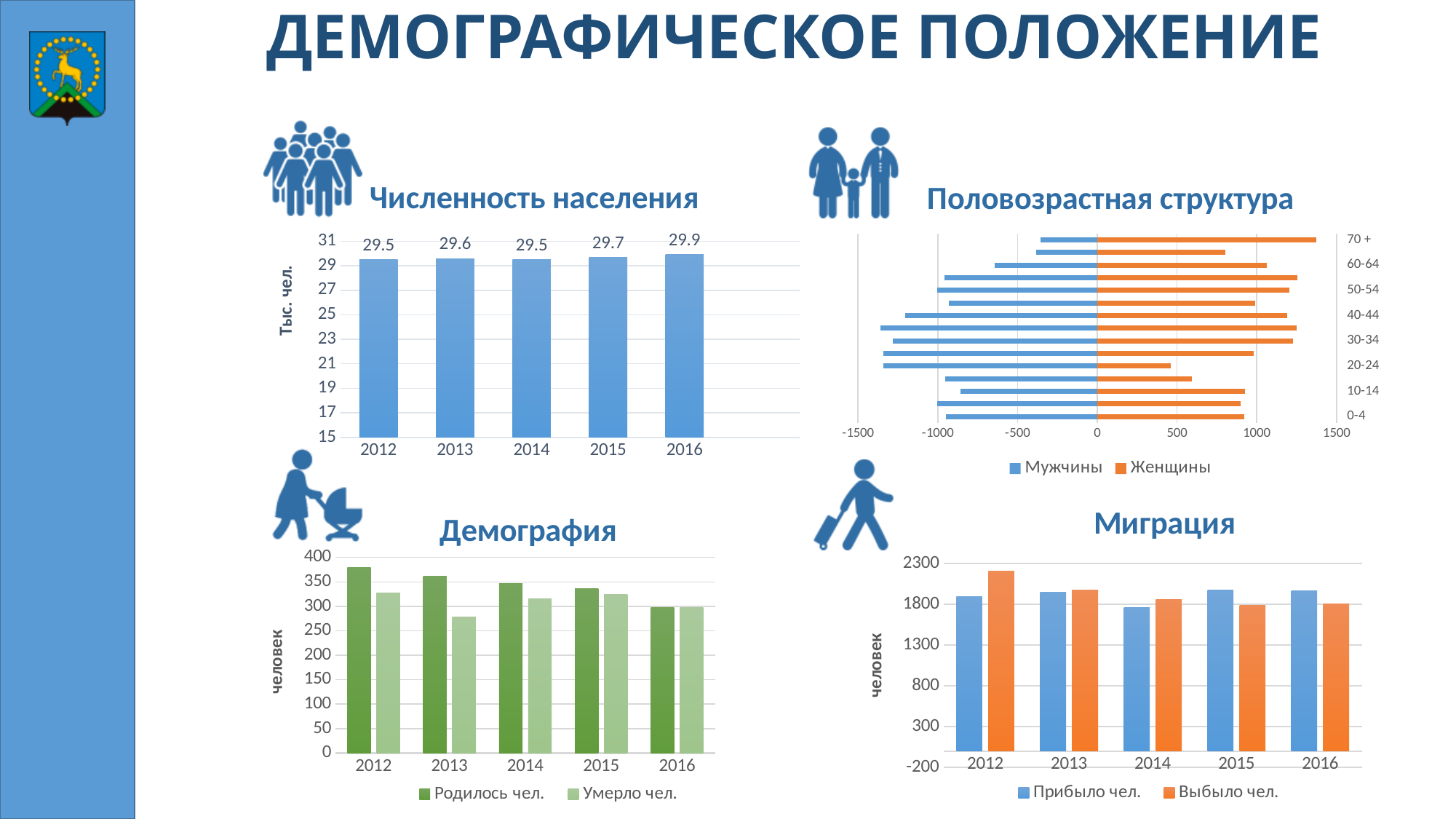
In the 'Численность населения' chart, which year has the highest value? 2016 In the 'Численность населения' chart, how many years are shown on the x axis? 5 In the 'Демография' chart, is the value for Умерло чел. in 2013 greater or less than 300? less In the 'Демография' chart, does the Родилось чел. series rise or fall from 2012 to 2016? fall What kind of chart is the 'Половозрастная структура' chart? bar chart In the 'Миграция' chart, which is larger in 2012: Прибыло чел. or Выбыло чел.? Выбыло чел. In the 'Численность населения' chart, what is the value for 2016? 29.9 In the 'Половозрастная структура' chart, is the value for Женщины in the 70 + group greater or less than 1000? greater How many series does the legend of the 'Половозрастная структура' chart list? 2 In the 'Демография' chart, is the value for Родилось чел. in 2012 greater or less than 350? greater In the 'Численность населения' chart, what is the difference between the values for 2016 and 2012? 0.4